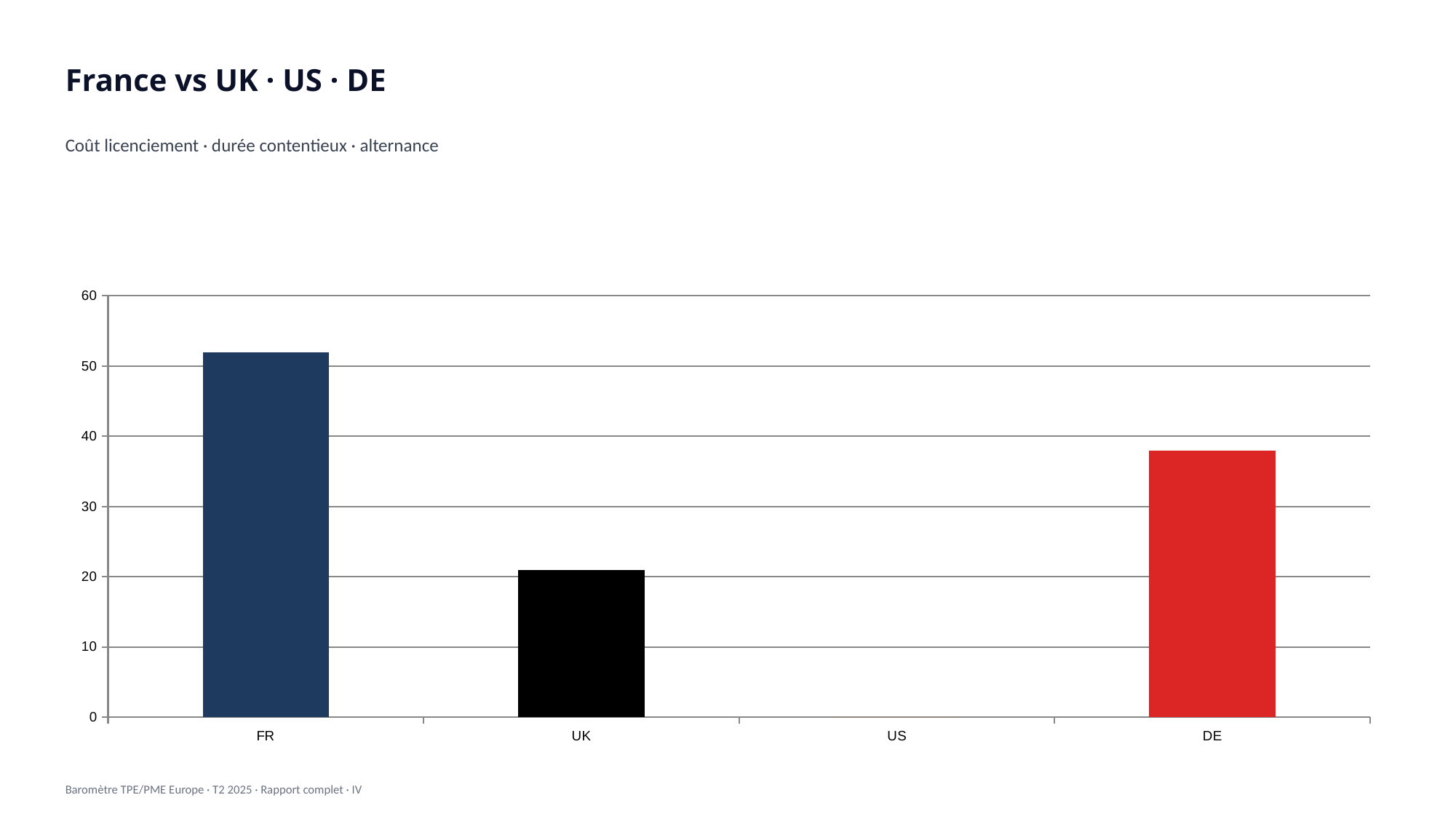
Which is larger, the value for UK or the value for DE? DE Is the value for UK greater or less than 30? less What colour is the bar for DE? red Which is larger, the value for FR or the value for DE? FR Is the value for DE greater or less than 30? greater Is the value for FR greater or less than 50? greater What is the title of the slide containing the chart? France vs UK · US · DE How many categories are shown on the x axis of the chart? 4 What kind of chart is shown on the slide? bar chart Which category has the highest bar in the chart? FR